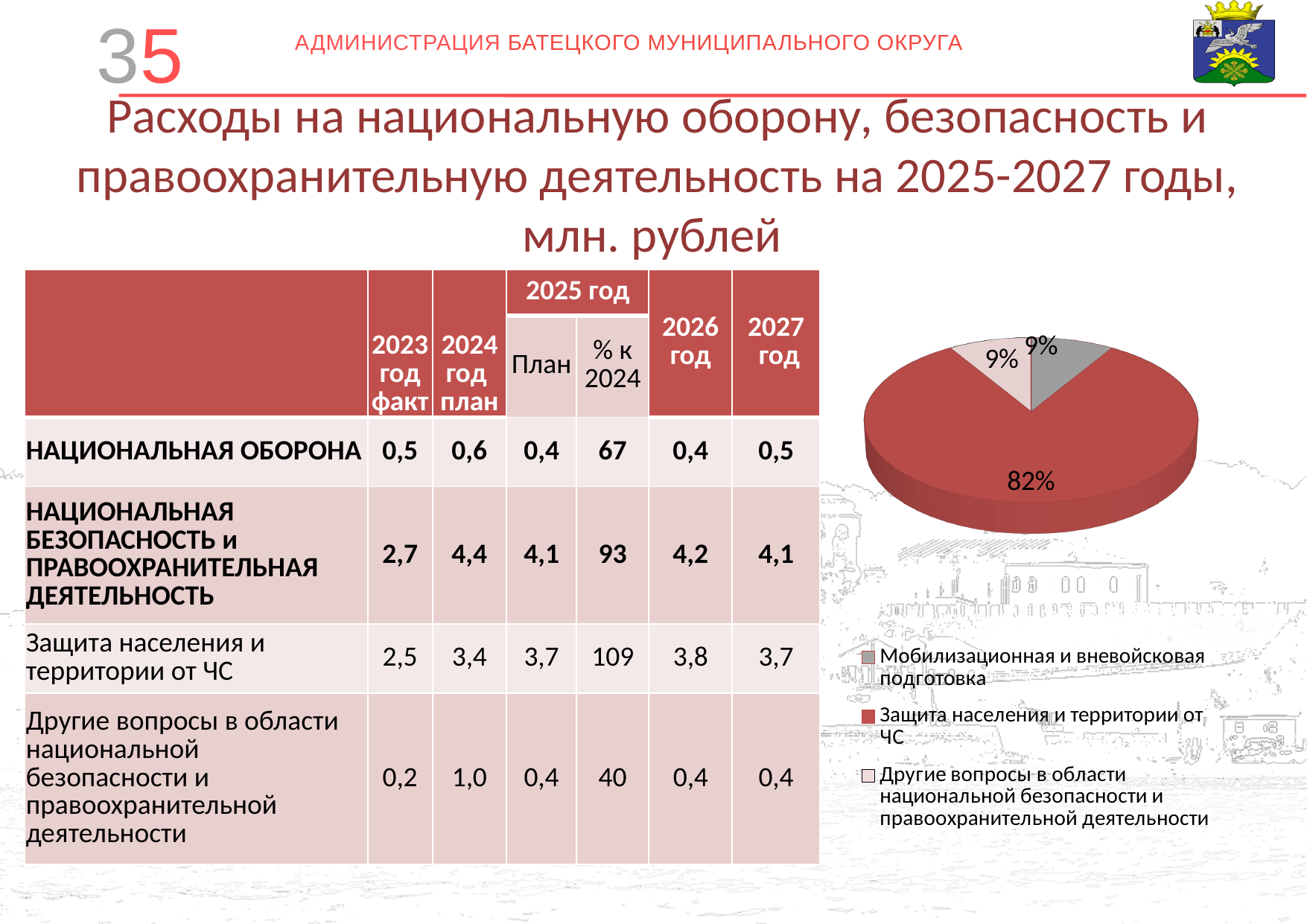
What colour is the largest slice of the pie chart? red Which category has the largest slice in the pie chart? Защита населения и территории от ЧС In the pie chart, what is the difference in percentage points between the "Защита населения и территории от ЧС" slice and the "Мобилизационная и вневойсковая подготовка" slice? 73 How many entries does the pie chart's legend list? 3 Which legend entry of the pie chart is shown in grey? Мобилизационная и вневойсковая подготовка How many slices does the pie chart have? 3 In the pie chart, what share is shown for "Другие вопросы в области национальной безопасности и правоохранительной деятельности"? 9% In the pie chart, what share is shown for "Мобилизационная и вневойсковая подготовка"? 9% In the pie chart, what share is shown for "Защита населения и территории от ЧС"? 82% In the pie chart, which is larger: the slice for "Защита населения и территории от ЧС" or the slice for "Мобилизационная и вневойсковая подготовка"? Защита населения и территории от ЧС What kind of chart is shown on the right side of the slide? pie chart